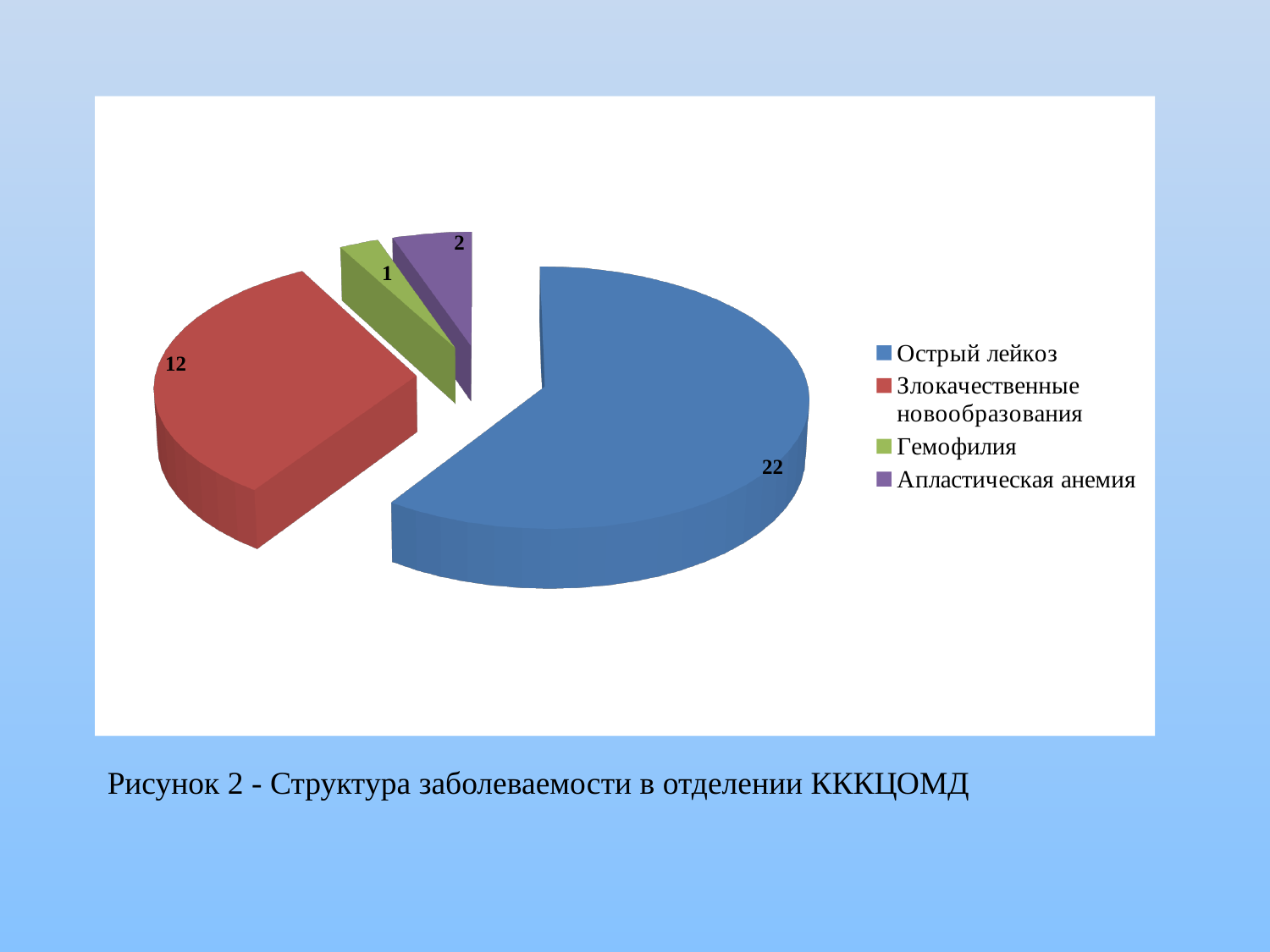
Which category has the smallest slice of the pie? Гемофилия How many categories does the pie chart have? 4 What is the value for Злокачественные новообразования? 12 Which is larger, the value for Апластическая анемия or the value for Гемофилия? Апластическая анемия What is the value for Апластическая анемия? 2 Which category has the largest slice of the pie? Острый лейкоз What is the value for Острый лейкоз? 22 What is the value for Гемофилия? 1 What is the total of all the slices in the pie chart? 37 What is the caption given below the chart? Рисунок 2 - Структура заболеваемости в отделении КККЦОМД What kind of chart is shown on the slide? Pie chart What is the difference between the values for Острый лейкоз and Злокачественные новообразования? 10